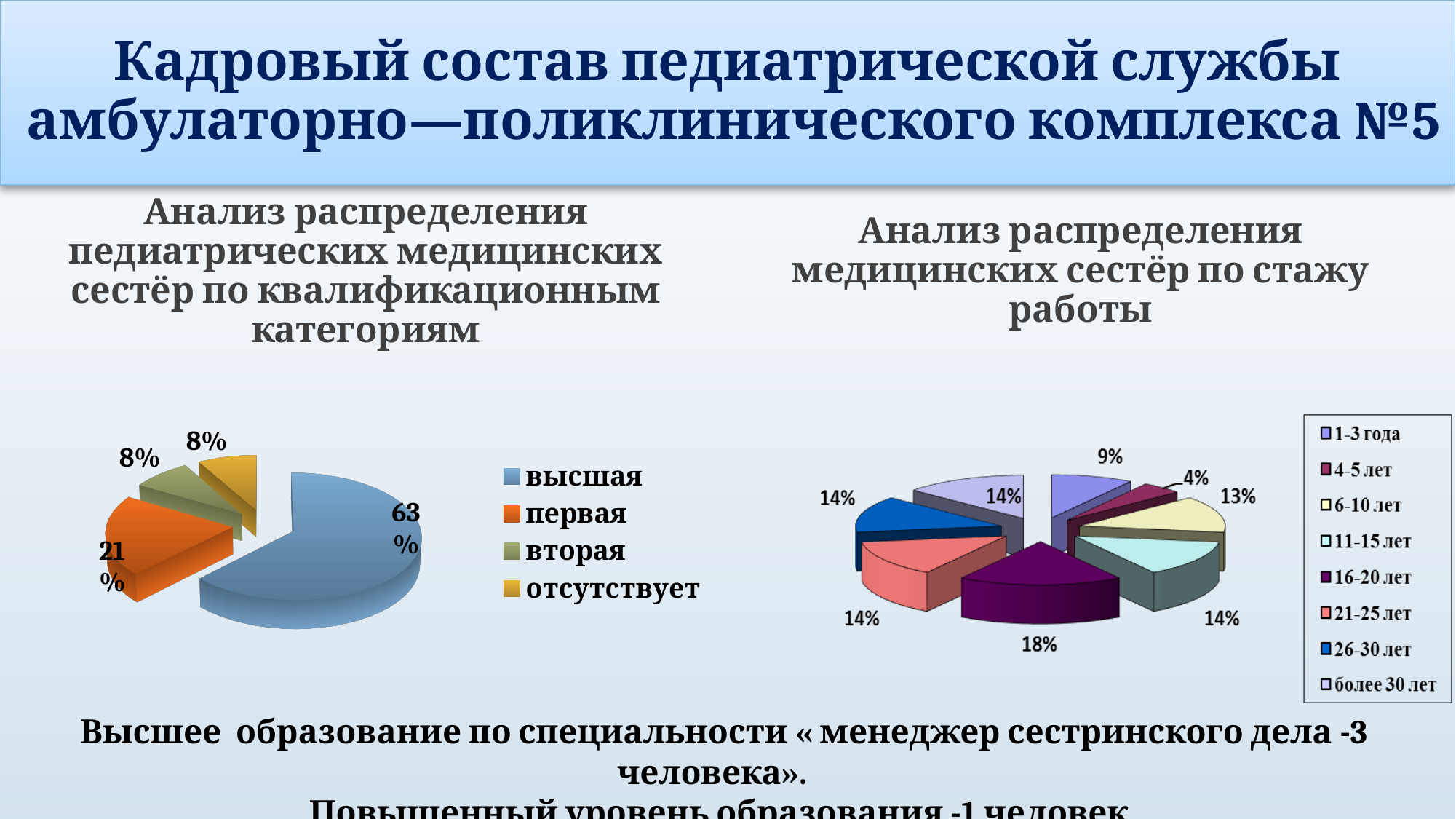
How many categories does the legend of the left pie chart on qualification categories list? 4 In the left pie chart on nurses' qualification categories, what share is labelled for the 'высшая' category? 63% In the left pie chart on nurses' qualification categories, what share is labelled for the 'первая' category? 21% In the right pie chart on work experience, which experience group has the smallest share? 4-5 лет How many experience groups does the legend of the right pie chart list? 8 In the right pie chart on work experience, what share is labelled for '16-20 лет'? 18% In the right pie chart on work experience, what share is labelled for '4-5 лет'? 4% In the right pie chart on work experience, which is larger: the share for '6-10 лет' or the share for '1-3 года'? 6-10 лет In the left pie chart on nurses' qualification categories, which category has the largest share? высшая In the right pie chart on work experience, which experience group has the largest share? 16-20 лет In the left pie chart on nurses' qualification categories, what is the difference between the 'высшая' and 'первая' shares? 42% What type of chart is used for the analysis of nurses by work experience on the right? Pie chart